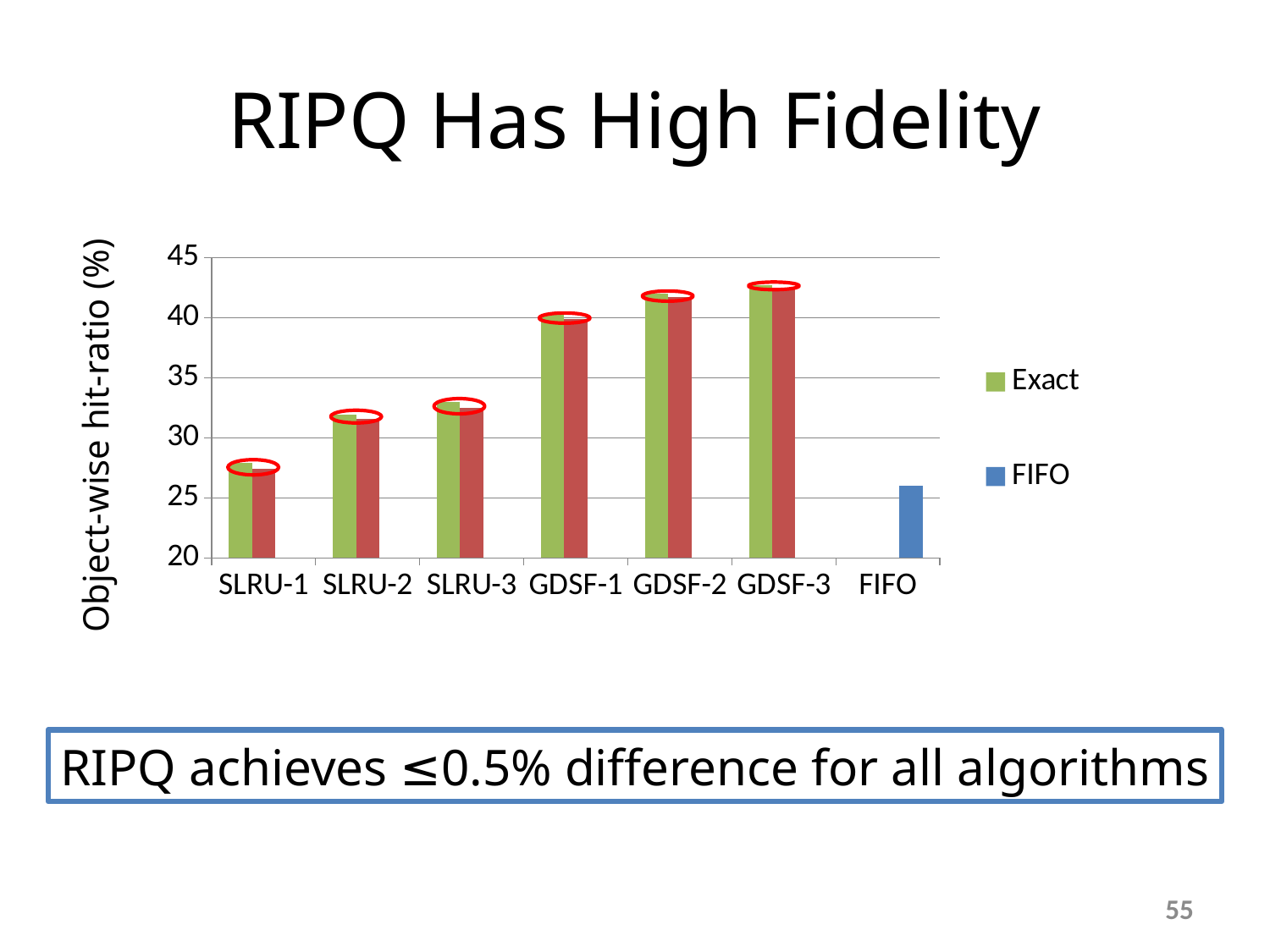
What kind of chart is shown on the slide? bar chart How many categories are shown on the x axis of the chart? 7 What is the label of the y axis of the chart? Object-wise hit-ratio (%) Which category has the highest Exact value? GDSF-3 Which has a larger Exact value, SLRU-3 or GDSF-1? GDSF-1 Is the value for FIFO greater or less than 30? less Is the Exact value for GDSF-3 greater or less than 45? less Is the Exact value for SLRU-1 greater or less than 30? less Do the Exact values rise or fall from SLRU-1 to GDSF-3? rise Which category has the lowest Exact value? SLRU-1 How many series does the chart's legend list? 2